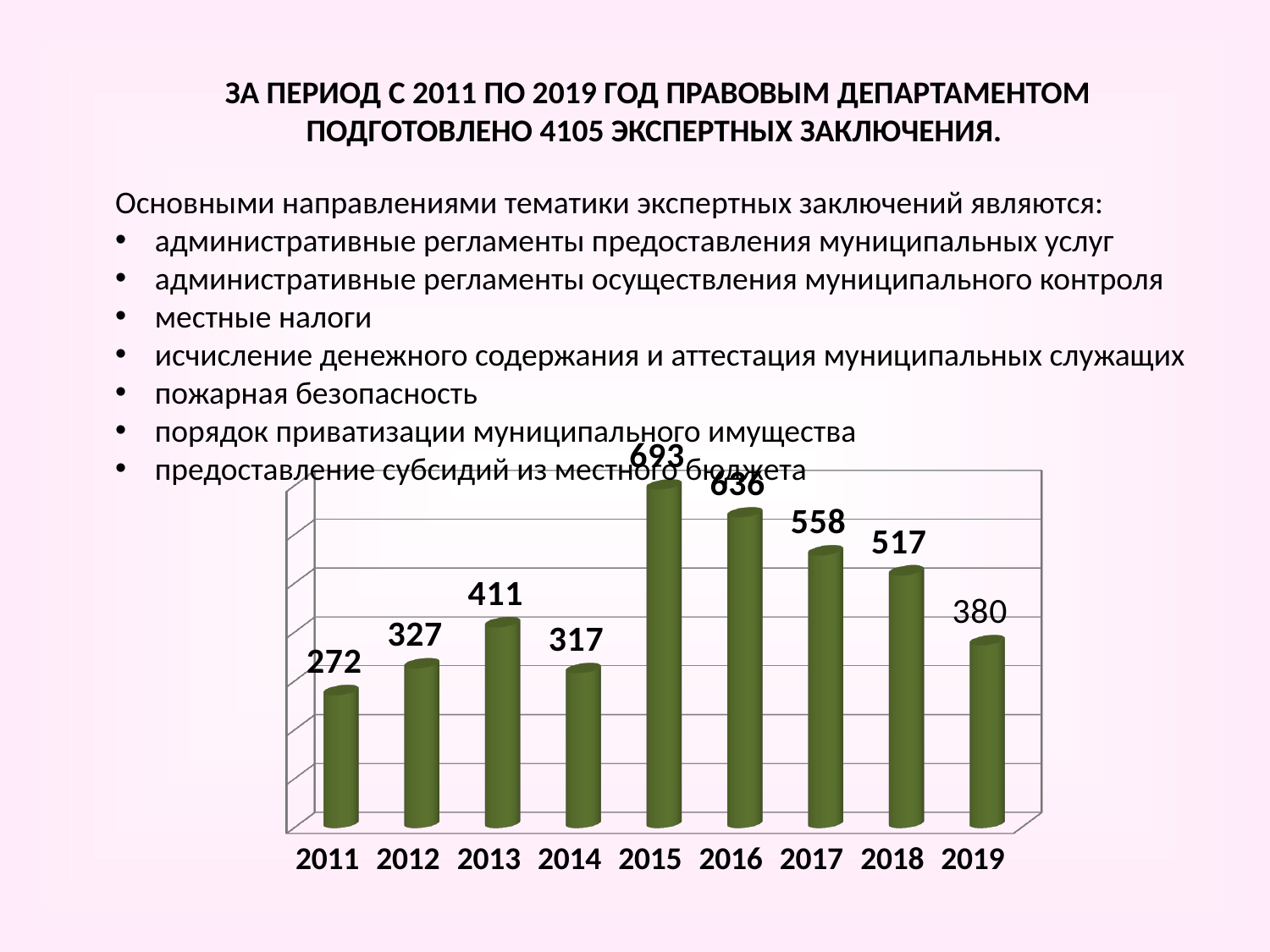
How many years are shown on the x axis? 9 What is the value for 2019? 380 Which year has the lowest value? 2011 What is the value for 2011? 272 What is the value for 2015? 693 What is the difference between the values for 2015 and 2016? 57 What is the difference between the values for 2013 and 2014? 94 Do the values rise or fall from 2016 to 2019? fall What kind of chart is shown on the slide? bar chart Which year has the highest value? 2015 What is the value for 2017? 558 Which is larger, the value for 2012 or the value for 2014? 2012